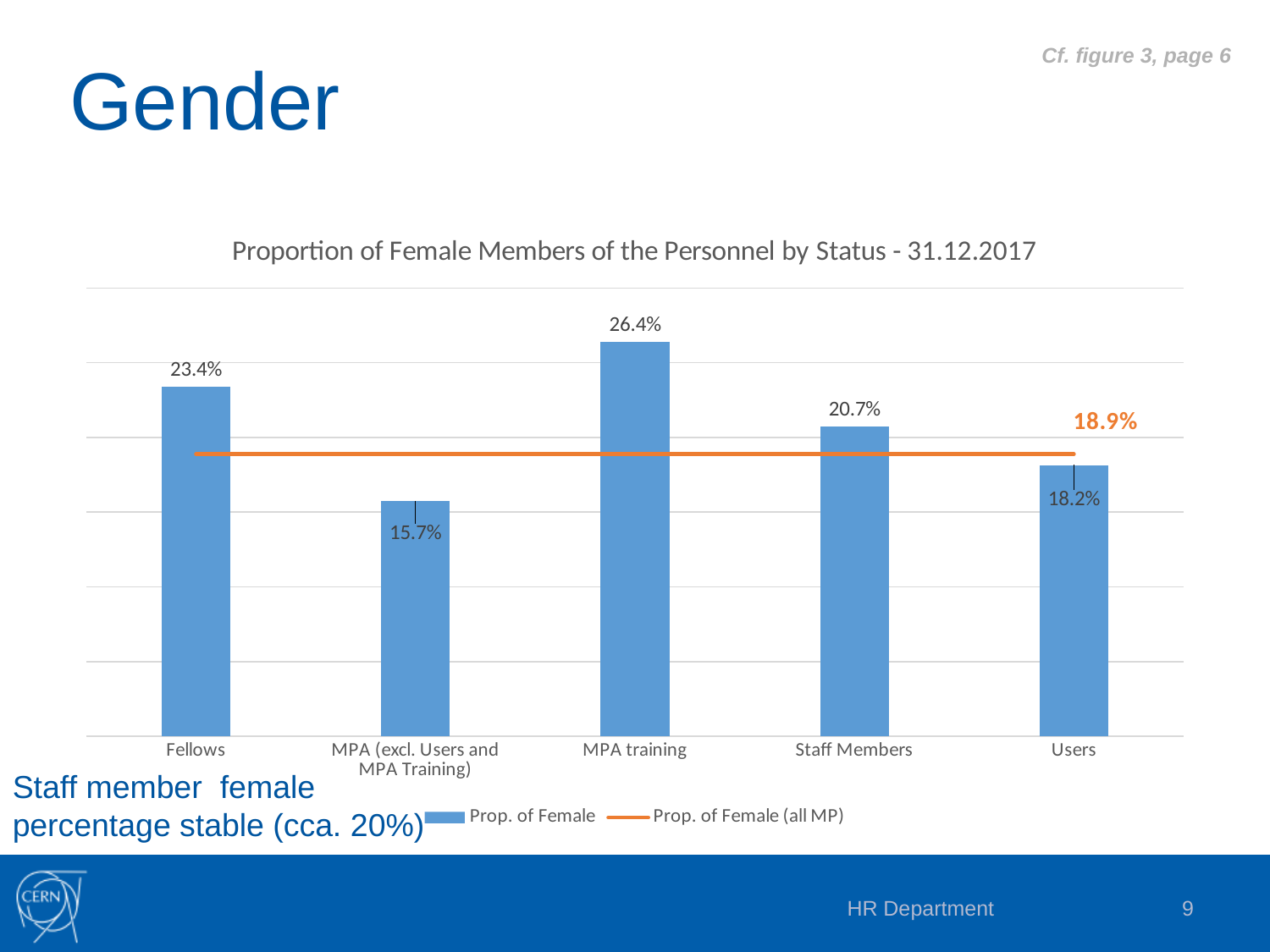
What value is shown for the 'Prop. of Female (all MP)' line? 18.9% What is the difference between the proportion of female members for MPA training and for Fellows? 3.0% What is the proportion of female members for Fellows? 23.4% Which has a higher proportion of female members, Staff Members or Users? Staff Members What is the proportion of female members for MPA training? 26.4% Which status category has the highest proportion of female members? MPA training What is the proportion of female members for Staff Members? 20.7% How many series does the legend list? 2 What type of chart is shown on the slide? Bar chart with a line Which status category has the lowest proportion of female members? MPA (excl. Users and MPA Training) How many status categories are shown on the x axis? 5 What is the proportion of female members for Users? 18.2%